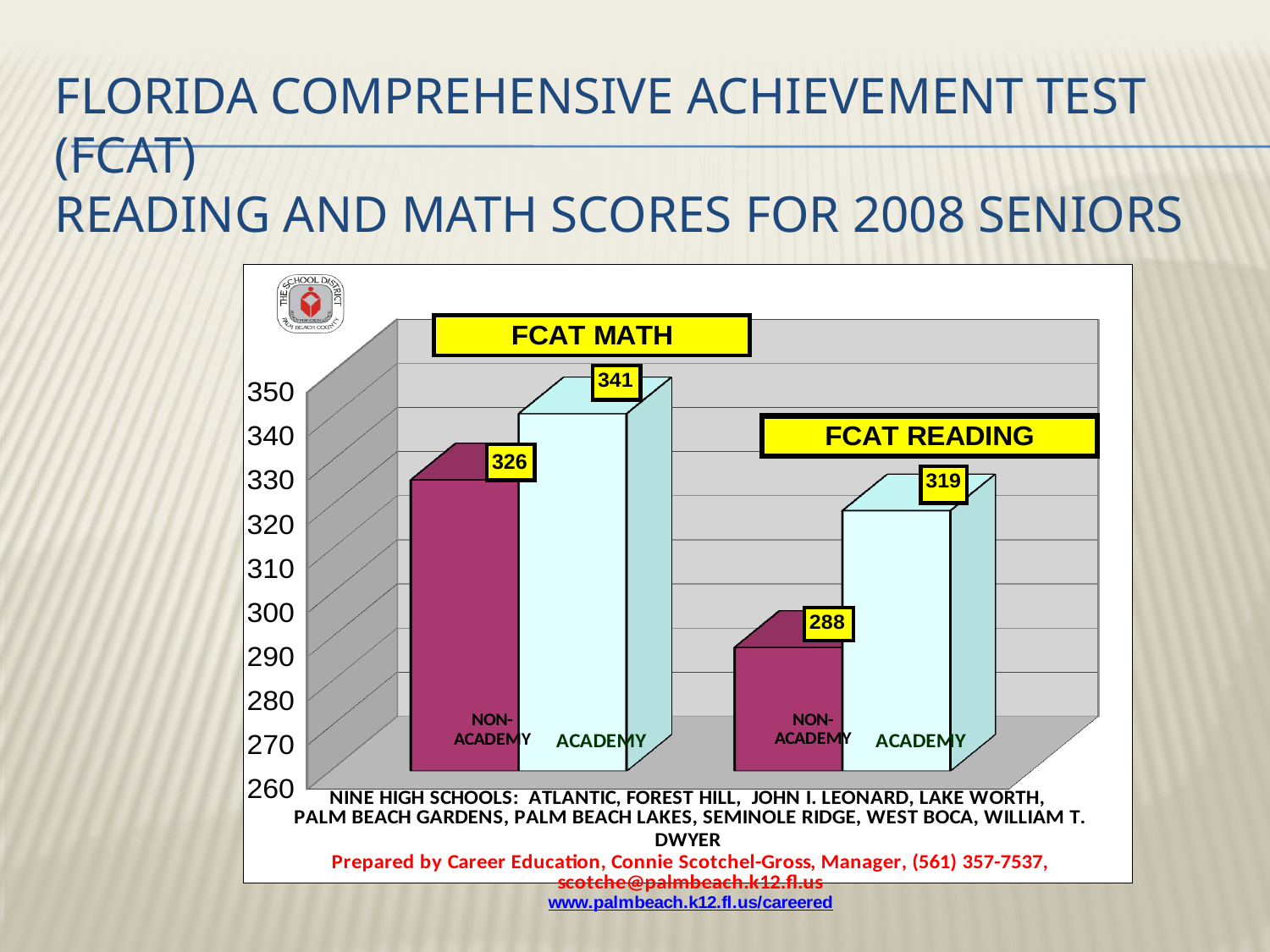
What is the FCAT Reading score for Non-Academy students? 288 How many bars are plotted on the chart? 4 Which bar has the highest value on the chart? FCAT Math Academy What is the FCAT Reading score for Academy students? 319 What is the FCAT Math score for Non-Academy students? 326 What is the difference between the Academy and Non-Academy FCAT Math scores? 15 Which bar has the lowest value on the chart? FCAT Reading Non-Academy What is the lowest value shown on the vertical axis? 260 What is the difference between the Academy and Non-Academy FCAT Reading scores? 31 What is the FCAT Math score for Academy students? 341 What kind of chart is shown on the slide? Bar chart Which is larger, the Non-Academy FCAT Math score or the Academy FCAT Reading score? Non-Academy FCAT Math